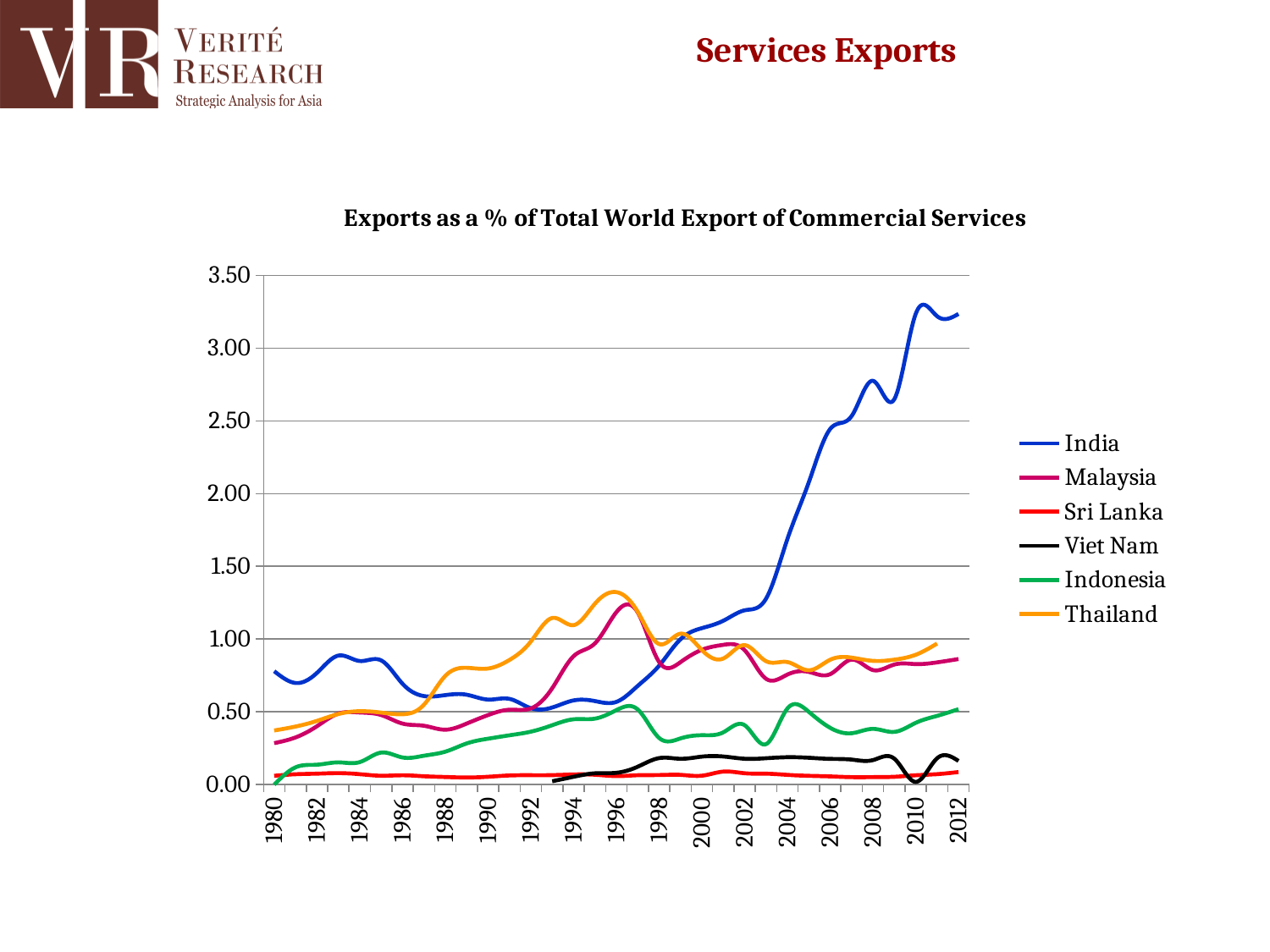
Is the value for Thailand in 1996 greater or less than 1.00? greater What is the title of the chart? Exports as a % of Total World Export of Commercial Services Which series' line starts in 1993 rather than 1980? Viet Nam Which series has the highest value in 2012? India Is the value for India in 2006 greater or less than 2.00? greater Is the value for India in 2012 greater or less than 3.00? greater How many series does the legend list? 6 Which is larger in 1990, the value for Thailand or the value for Malaysia? Thailand Which series has the lowest value in 2012? Sri Lanka Does the value for India rise or fall between 2003 and 2010? rise What kind of chart is shown on the slide? line chart